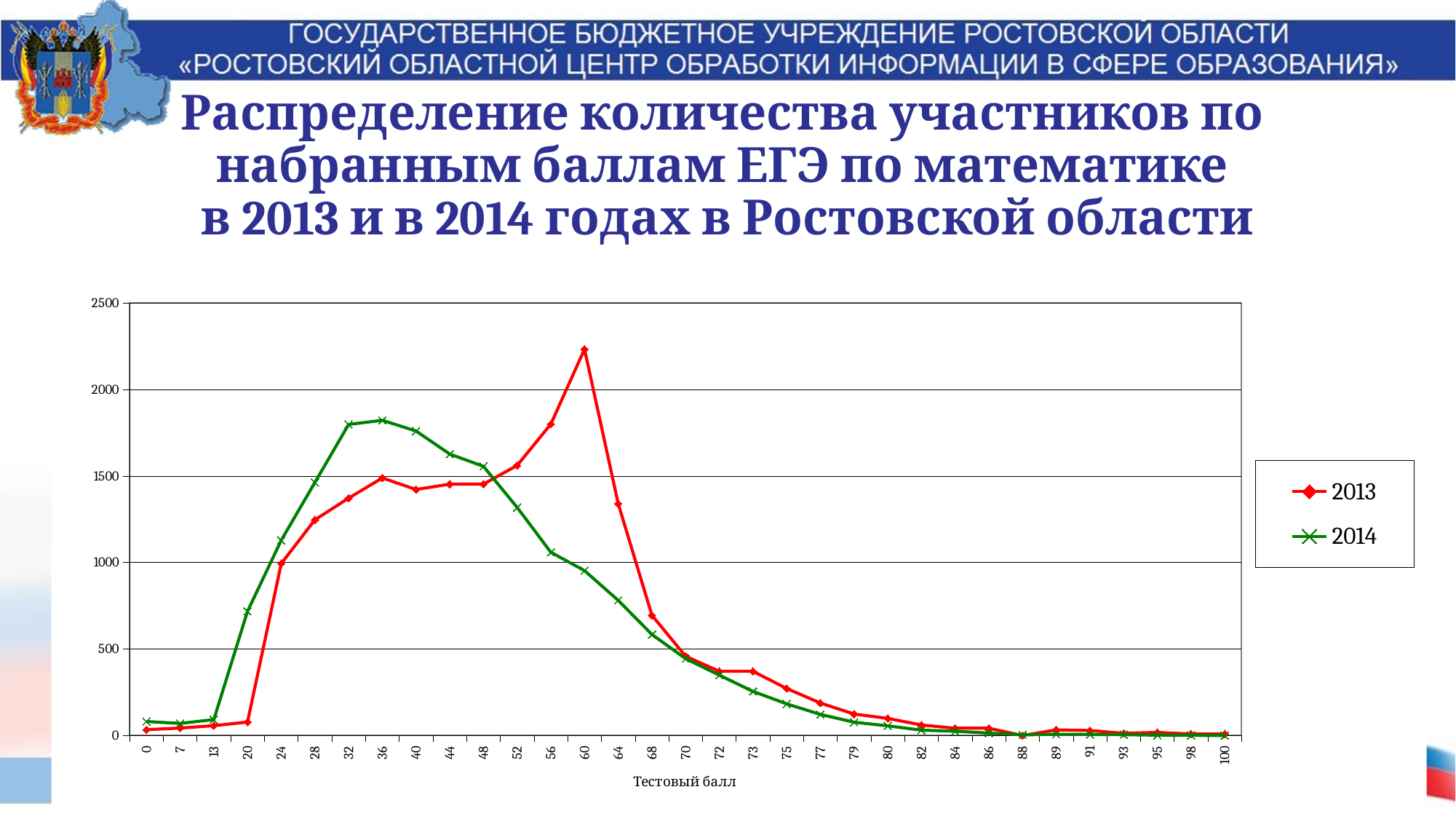
Does the 2013 series rise or fall from test score 60 to test score 100? fall How many series does the legend list? 2 Is the value for 2014 at test score 20 greater or less than 500? greater Is the value for 2013 at test score 60 greater or less than 2000? greater What kind of chart is shown on the slide? line chart Is the value for 2014 at test score 36 greater or less than 2000? less Which years are listed in the legend? 2013 and 2014 At test score 32, which series has the larger value, 2013 or 2014? 2014 How many test score categories are shown on the x axis? 33 At which test score does the 2013 series reach its highest value? 60 What is the label of the x axis? Тестовый балл